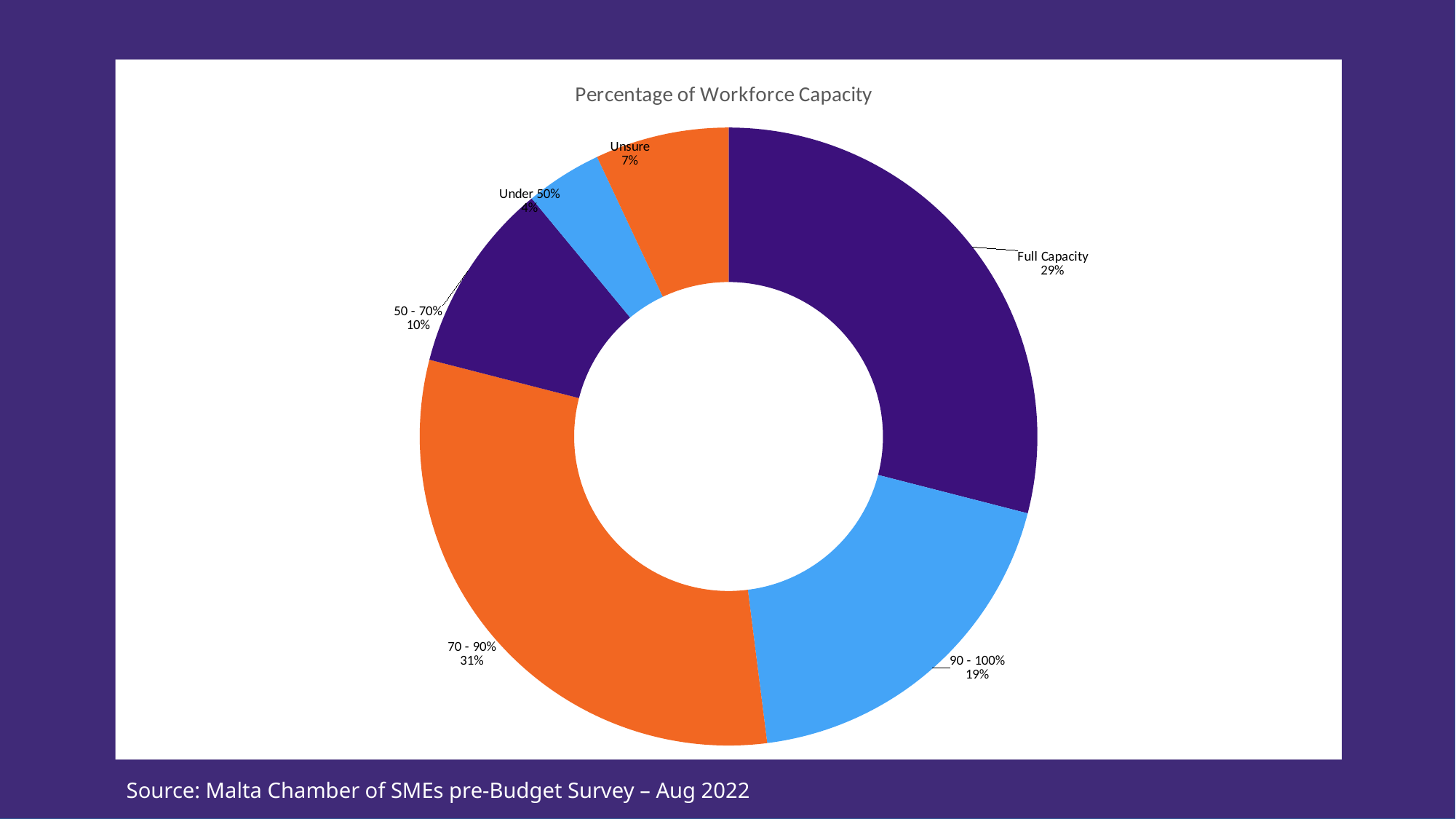
What is the value shown for the 70 - 90% slice? 31% What kind of chart is shown on the slide? Doughnut chart What is the difference between the 70 - 90% share and the Full Capacity share? 2% What is the value shown for the 90 - 100% slice? 19% What is the value shown for the Unsure slice? 7% Which category has the largest share of the chart? 70 - 90% What is the value shown for the 50 - 70% slice? 10% Which category has the smallest share of the chart? Under 50% Which is larger, the Full Capacity share or the 90 - 100% share? Full Capacity What percentage of the pie is labelled Full Capacity? 29% What is the title of the chart? Percentage of Workforce Capacity How many categories are shown in the chart? 6